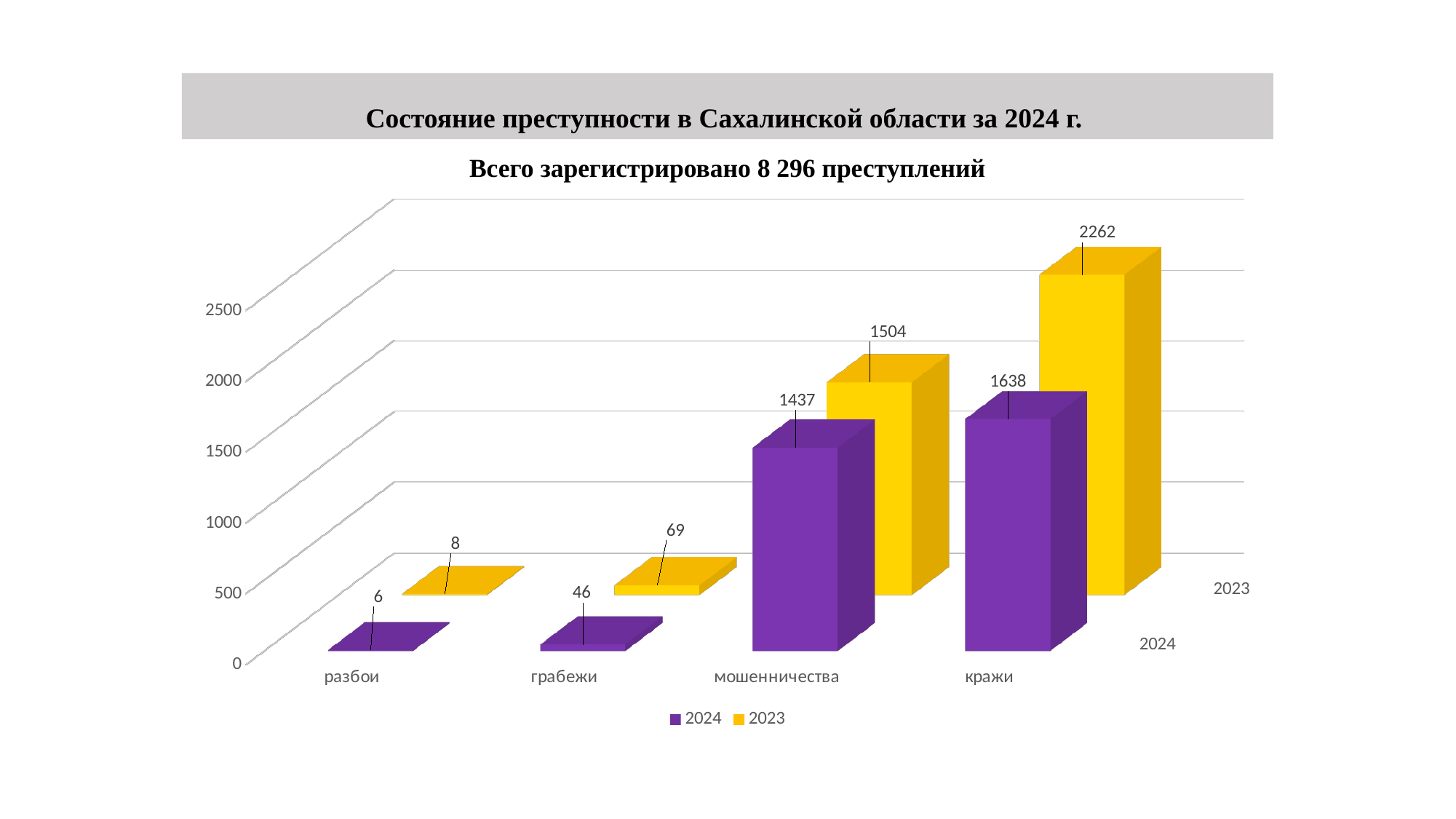
What is the value for мошенничества in the 2023 series? 1504 What is the value for кражи in the 2024 series? 1638 What kind of chart is shown on the slide? bar chart How many series does the legend list? 2 What is the value for разбои in the 2023 series? 8 How many categories are shown on the x axis? 4 What is the difference between the 2023 and 2024 values for кражи? 624 Which category has the highest value in the 2023 series? кражи What is the value for грабежи in the 2024 series? 46 What is the title of the chart? Всего зарегистрировано 8 296 преступлений Which is larger for мошенничества: the 2024 value or the 2023 value? 2023 Which category has the lowest value in the 2024 series? разбои